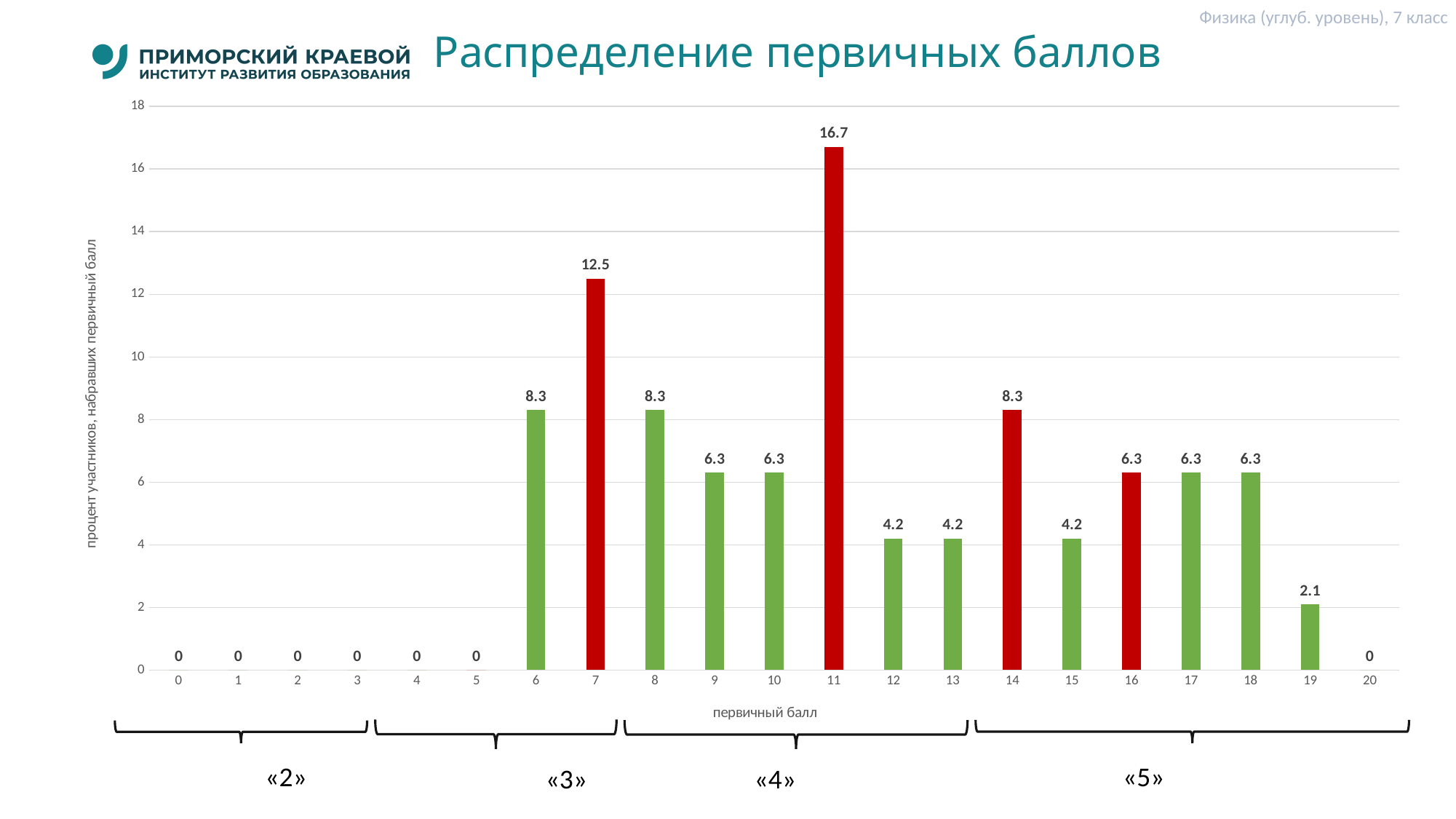
What is the value for primary score 15? 4.2 What is the value for primary score 7? 12.5 What type of chart is shown on the slide? bar chart What is the value for primary score 19? 2.1 What is the difference between the values for primary scores 11 and 7? 4.2 What is the difference between the values for primary scores 6 and 12? 4.1 How many primary score categories are shown on the x axis? 21 What is the title of the chart? Распределение первичных баллов What is the label of the x axis? первичный балл Which is larger, the value for primary score 14 or the value for primary score 16? 14 What is the value for primary score 11? 16.7 Which primary score has the highest percentage of participants? 11